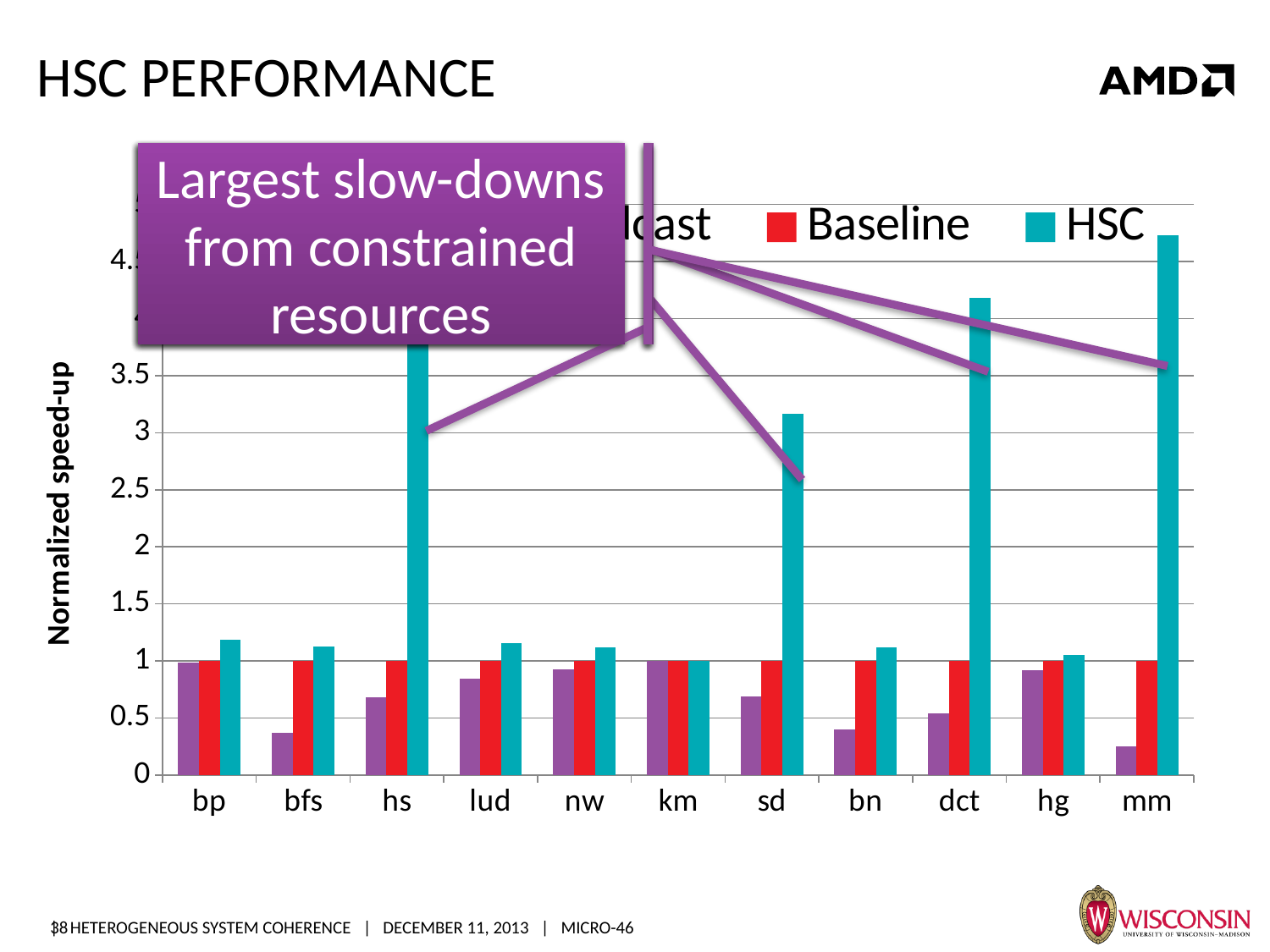
Is the HSC value for dct greater or less than 4? greater Is the purple series value for bfs greater or less than 0.5? less What kind of chart is shown on the slide? bar chart Is the HSC value for mm greater or less than 4.5? greater How many categories are shown along the x axis of the chart? 11 How many series does the chart's legend list? 3 Which is larger, the HSC value for sd or the HSC value for dct? dct Which category has the lowest value for the purple series? mm Which colour represents the HSC series in the chart? teal What is the title of the y axis of the chart? Normalized speed-up